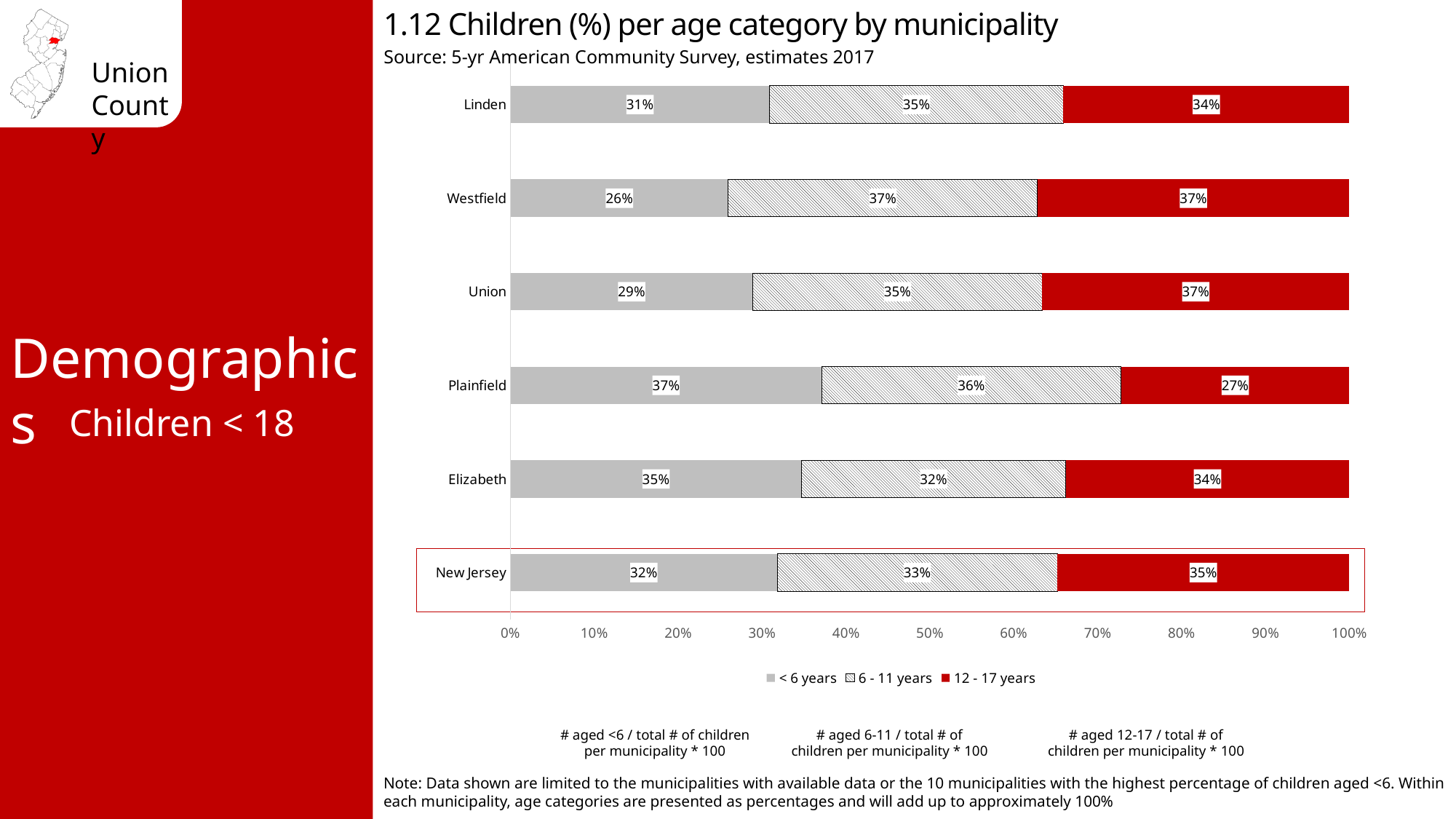
What is the total of the three age category percentages for Linden? 100% What percentage of children in Westfield are under 6 years old? 26% What kind of chart is shown on the slide? Stacked bar chart Which municipality has the lowest percentage of children under 6 years? Westfield How many municipalities (including New Jersey) are shown on the chart? 6 What percentage of children in New Jersey are aged 6 - 11 years? 33% What is the difference between the < 6 years percentage for Plainfield and for Westfield? 11% What is the value for the 12 - 17 years series for Plainfield? 27% What is the title of the chart? 1.12 Children (%) per age category by municipality Which is larger for Elizabeth: the < 6 years share or the 6 - 11 years share? < 6 years Which municipality has the highest percentage of children under 6 years? Plainfield How many series does the legend list? 3